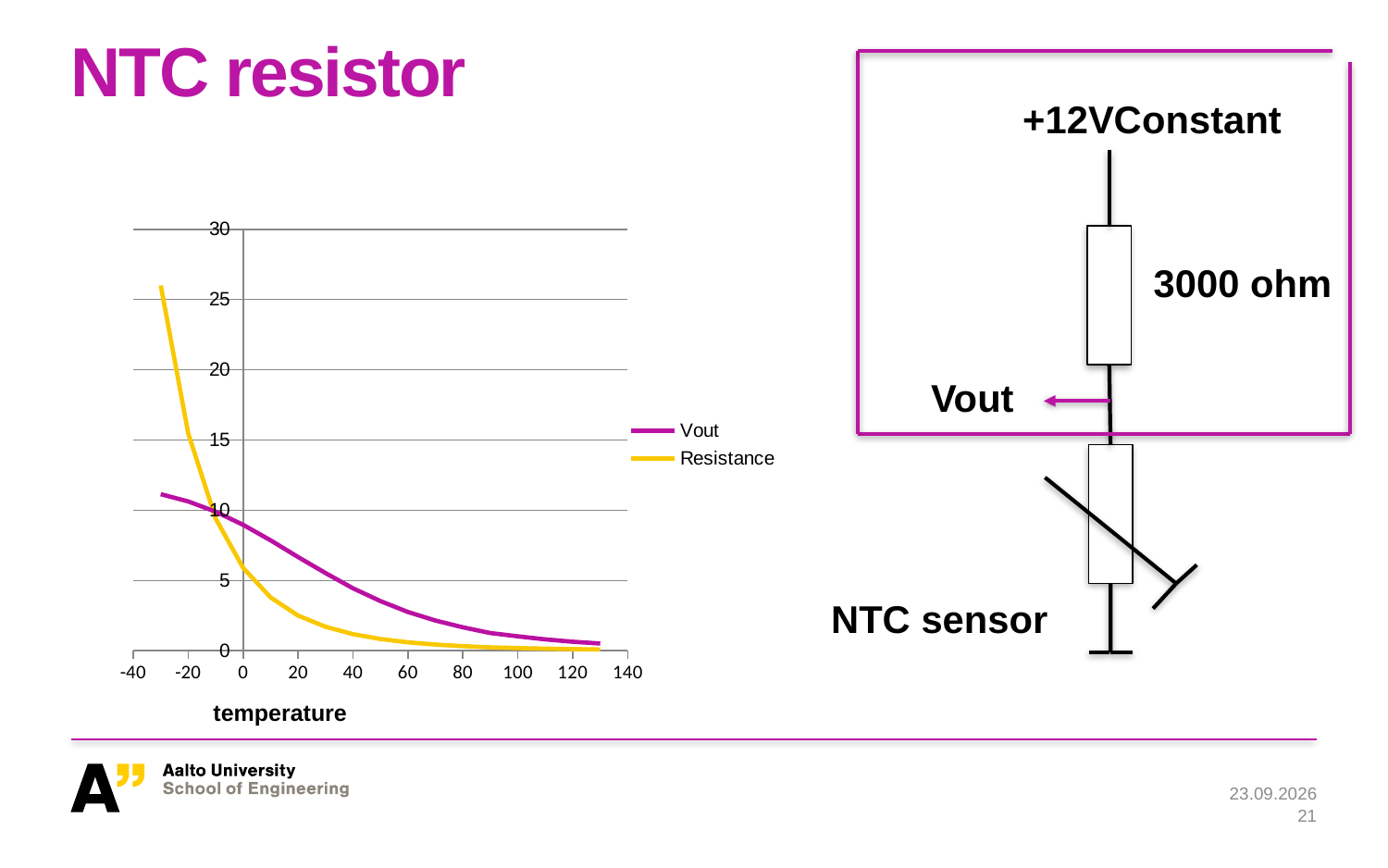
Is the Vout value at a temperature of -30 greater or less than 15? less Is the Vout value at a temperature of 60 greater or less than 5? less At a temperature of 60, which series has the larger value, Vout or Resistance? Vout Is the Resistance value at a temperature of 20 greater or less than 5? less What kind of chart is shown on the slide? line chart Does the Vout series rise or fall as temperature increases? fall What is the title of the chart's x axis? temperature At a temperature of -30, which series has the larger value, Vout or Resistance? Resistance What are the two series named in the chart's legend? Vout and Resistance How many series does the chart's legend list? 2 Does the Resistance series rise or fall as temperature increases? fall